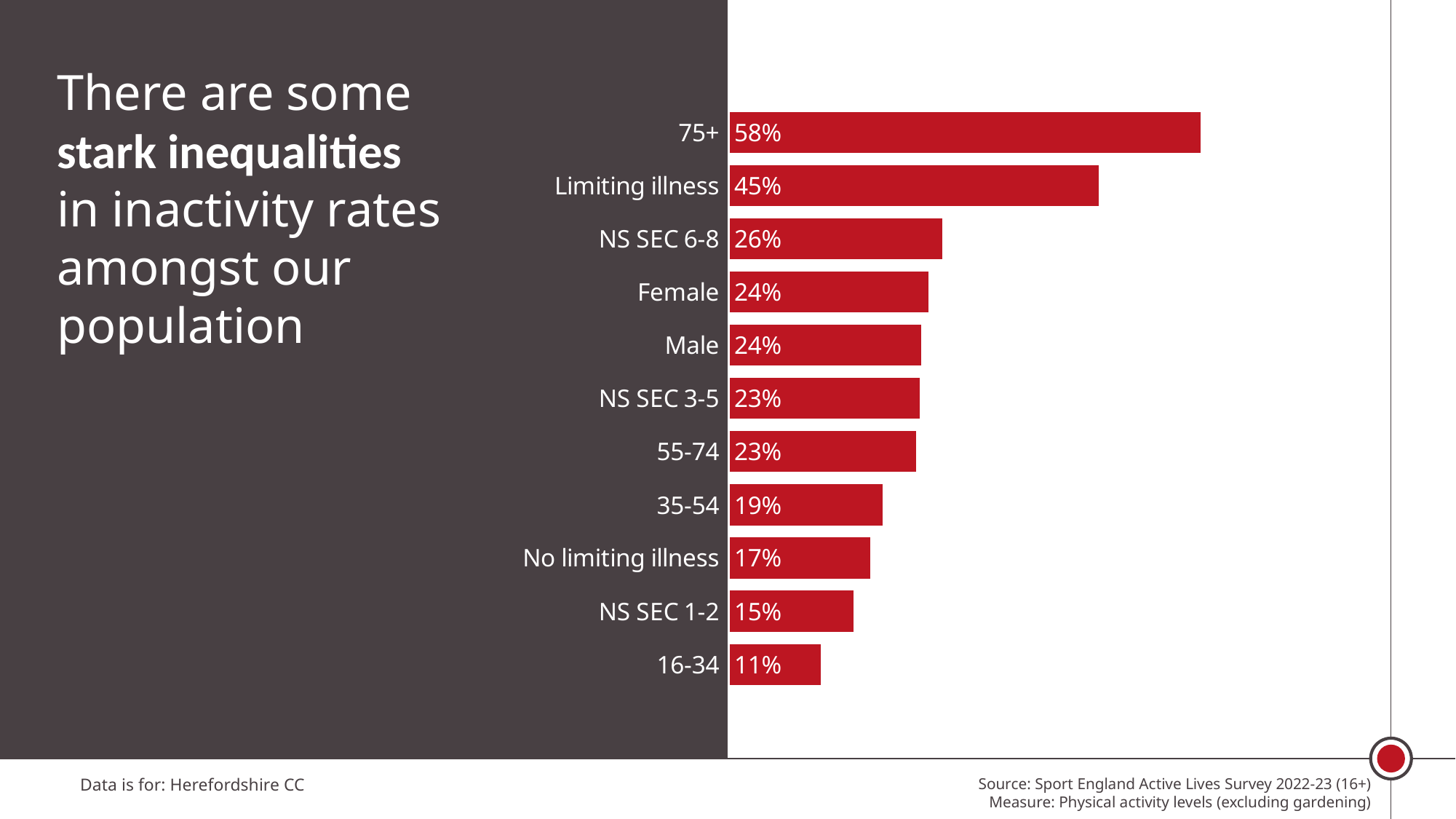
What colour are the bars in the chart? Red What is the difference between the values for Limiting illness and No limiting illness? 28% What is the difference between the values for 75+ and 16-34? 47% What is the value shown for Limiting illness? 45% What is the value shown for No limiting illness? 17% Which category has the lowest inactivity rate? 16-34 Which category has the highest inactivity rate? 75+ What kind of chart is shown on the slide? Bar chart What is the value shown for NS SEC 1-2? 15% Which has a higher value, NS SEC 6-8 or NS SEC 1-2? NS SEC 6-8 What is the inactivity rate for the 75+ category? 58% How many categories are shown in the chart? 11